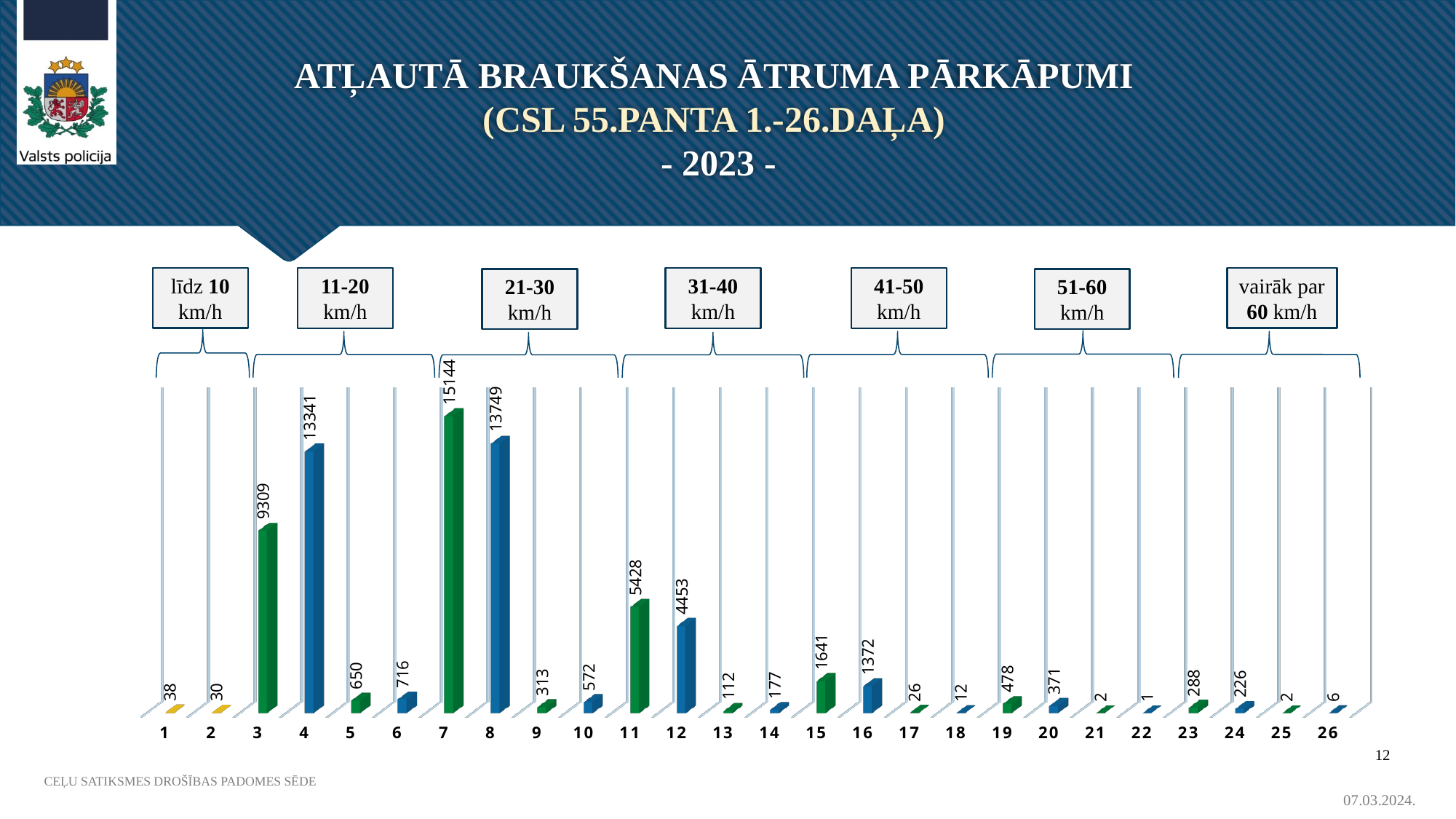
Which is larger, the value for category 3 or the value for category 4? 4 What is the value shown for category 16? 1372 What is the difference between the values for category 7 and category 8? 1395 What year is given in the chart title? 2023 Which category has the lowest value? 22 What is the value shown for category 4? 13341 What is the value shown for category 7? 15144 What kind of chart is shown on the slide? bar chart Which category has the highest value? 7 What is the value shown for category 11? 5428 What is the difference between the values for category 11 and category 12? 975 How many categories are shown on the x axis? 26